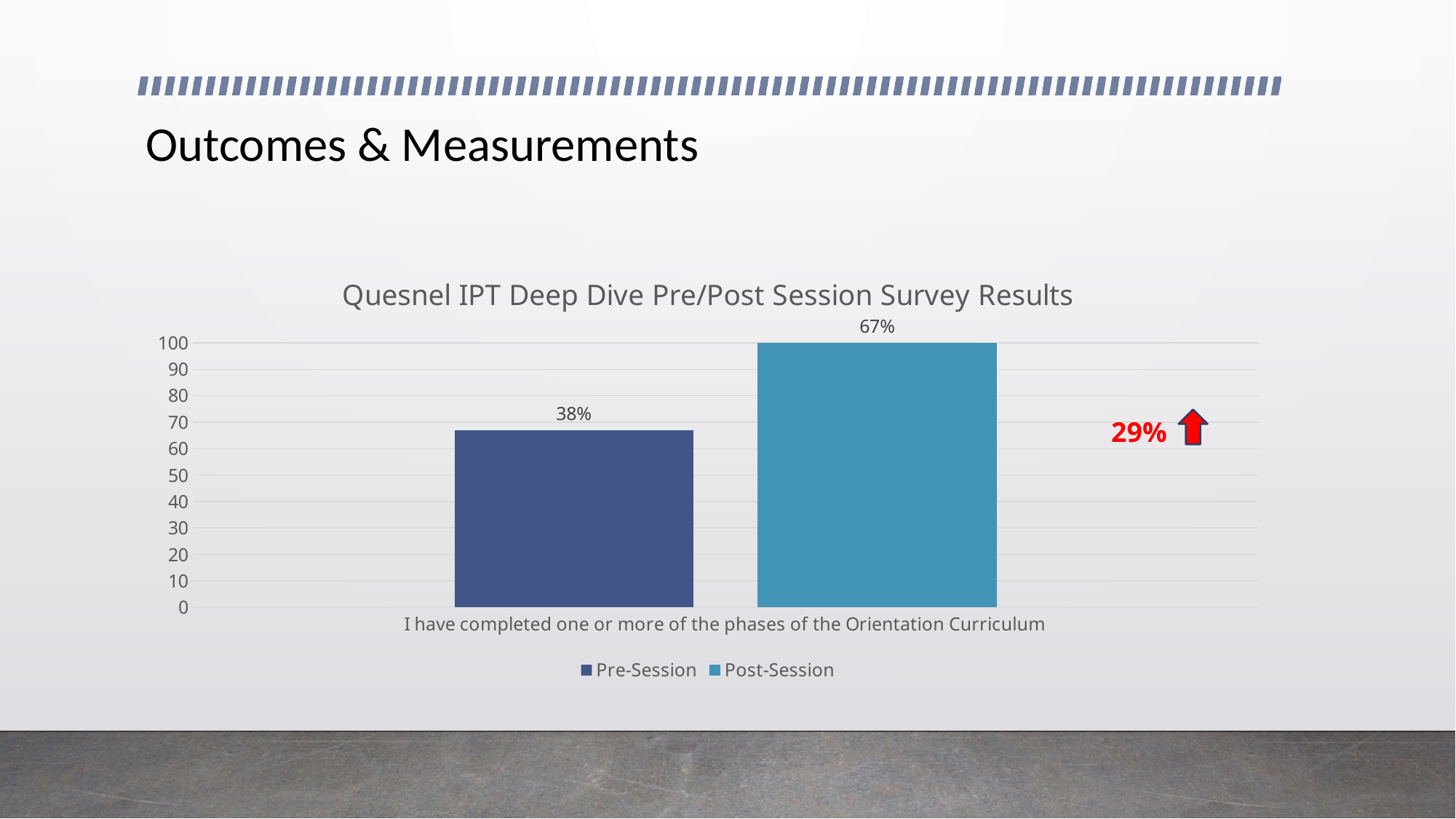
What is the Pre-Session value for "I have completed one or more of the phases of the Orientation Curriculum"? 38% How many categories are shown on the x axis? 1 What is the Post-Session value for "I have completed one or more of the phases of the Orientation Curriculum"? 67% Which series has the higher value, Pre-Session or Post-Session? Post-Session How many series does the legend list? 2 What is the difference between the Post-Session and Pre-Session values? 29% What is the highest tick value shown on the vertical axis? 100 Which series has the lowest value in the chart? Pre-Session What kind of chart is shown on the slide? Bar chart What is the title of the chart? Quesnel IPT Deep Dive Pre/Post Session Survey Results What are the two series named in the legend? Pre-Session and Post-Session